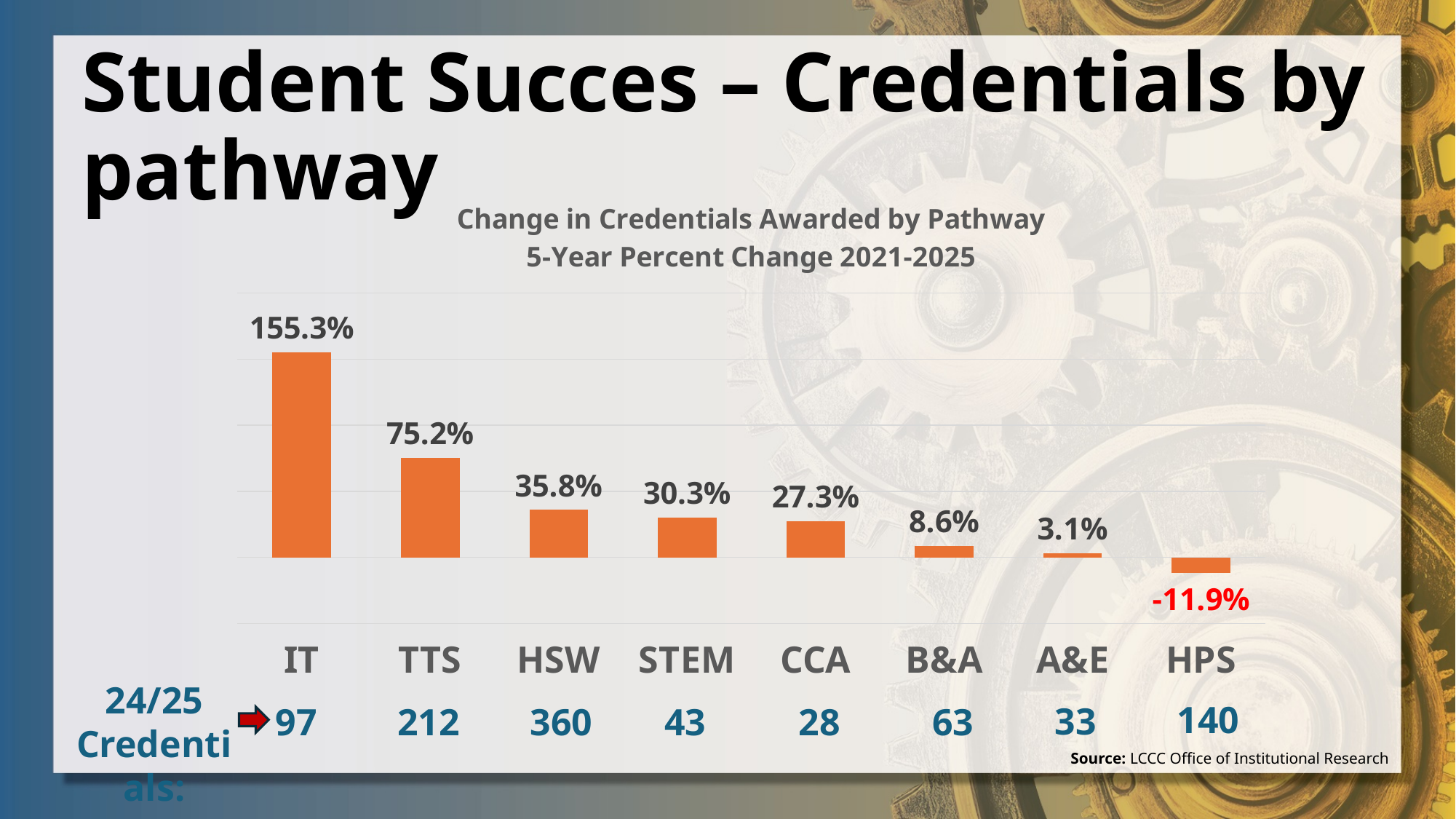
What is the difference between the percent change for IT and TTS? 80.1% How many pathways are shown in the chart? 8 Which has a larger percent change, STEM or CCA? STEM Do the percent change values rise or fall from left to right across the pathways? Fall What is the title of the chart? Change in Credentials Awarded by Pathway 5-Year Percent Change 2021-2025 Which pathway has the lowest 5-year percent change? HPS What is the 5-year percent change for HPS? -11.9% What is the 5-year percent change for IT? 155.3% What is the 5-year percent change for B&A? 8.6% Which pathway has the highest 5-year percent change? IT What is the 5-year percent change for HSW? 35.8% What type of chart is shown? Bar chart